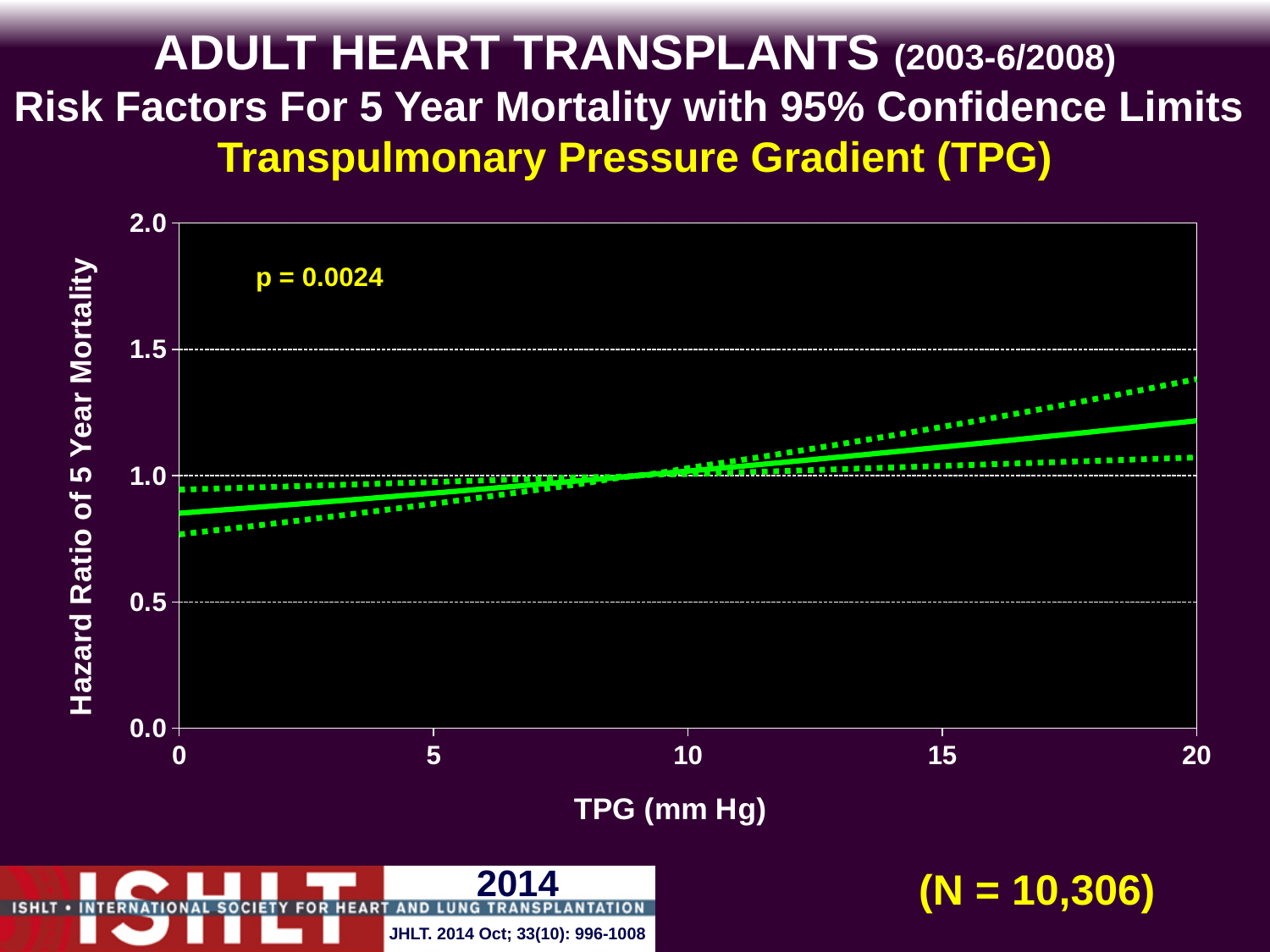
Is the hazard ratio on the solid line at a TPG of 20 mm Hg greater or less than 1.0? greater What is the maximum value shown on the y axis? 2.0 What is the label of the x axis? TPG (mm Hg) What kind of chart is shown on the slide? line chart How many lines are plotted on the chart, including the confidence limits? 3 Is the hazard ratio on the solid line at a TPG of 0 mm Hg greater or less than 1.0? less Is the lower confidence limit at a TPG of 0 mm Hg greater or less than 0.5? greater Does the hazard ratio of 5 year mortality rise or fall as TPG increases from 0 to 20 mm Hg? rise What p-value is printed on the chart? p = 0.0024 What is the maximum TPG value shown on the x axis? 20